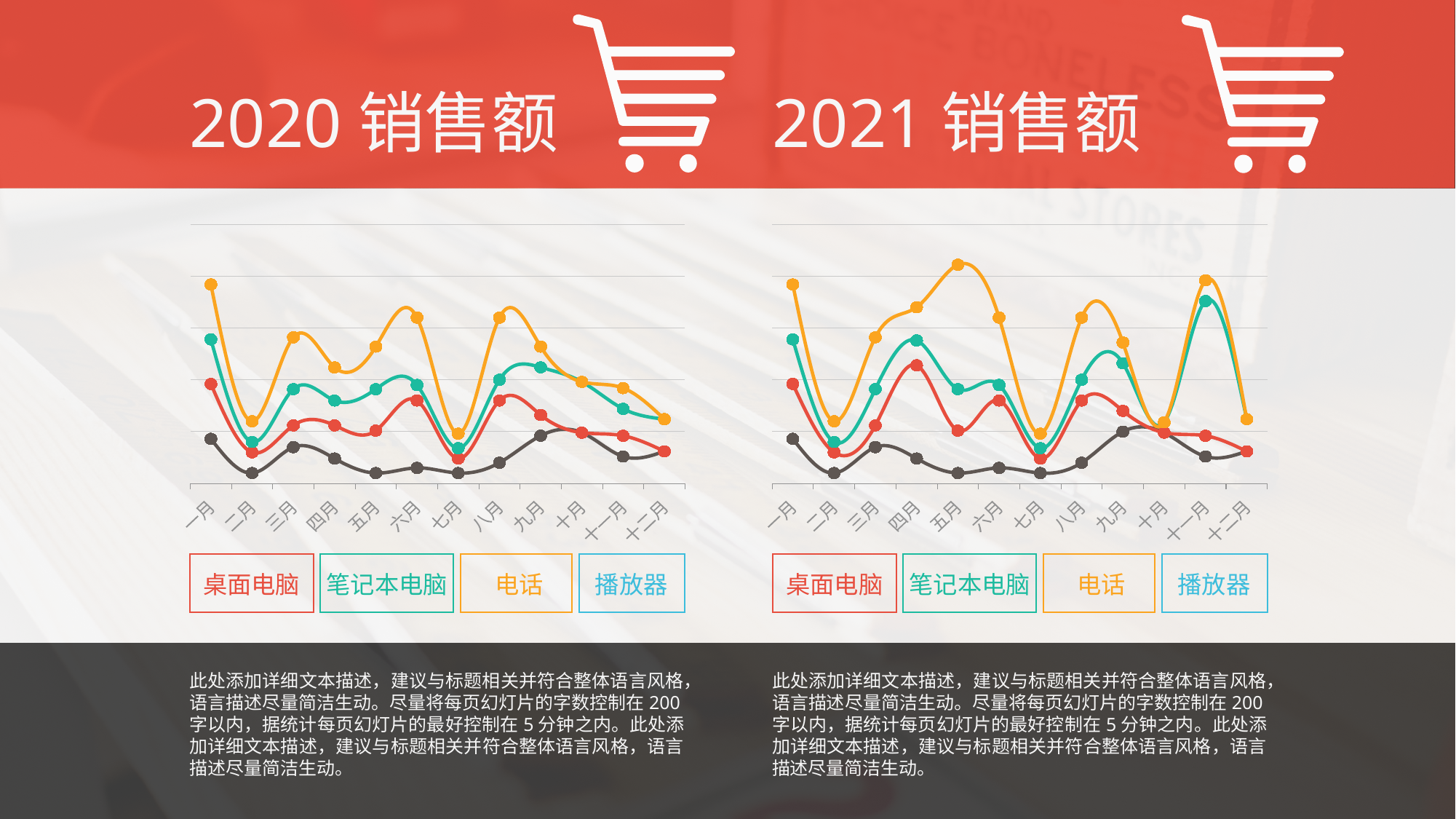
In the 2020 销售额 chart, in which month does the 电话 series reach its highest point? 一月 How many months are plotted along the x axis of the 2021 销售额 chart? 12 In the 2021 销售额 chart, in which month does the 笔记本电脑 series reach its highest point? 十一月 In the 2021 销售额 chart, in 五月, is 电话 or 笔记本电脑 higher? 电话 In the 2020 销售额 chart, which series has the highest value in 一月? 电话 In the 2020 销售额 chart, in 九月, is 笔记本电脑 or 桌面电脑 higher? 笔记本电脑 How many series does the legend of the 2020 销售额 chart list? 4 In the 2021 销售额 chart, does the 播放器 series rise or fall from 一月 to 二月? Fall What kind of chart is the 2020 销售额 chart? Line chart